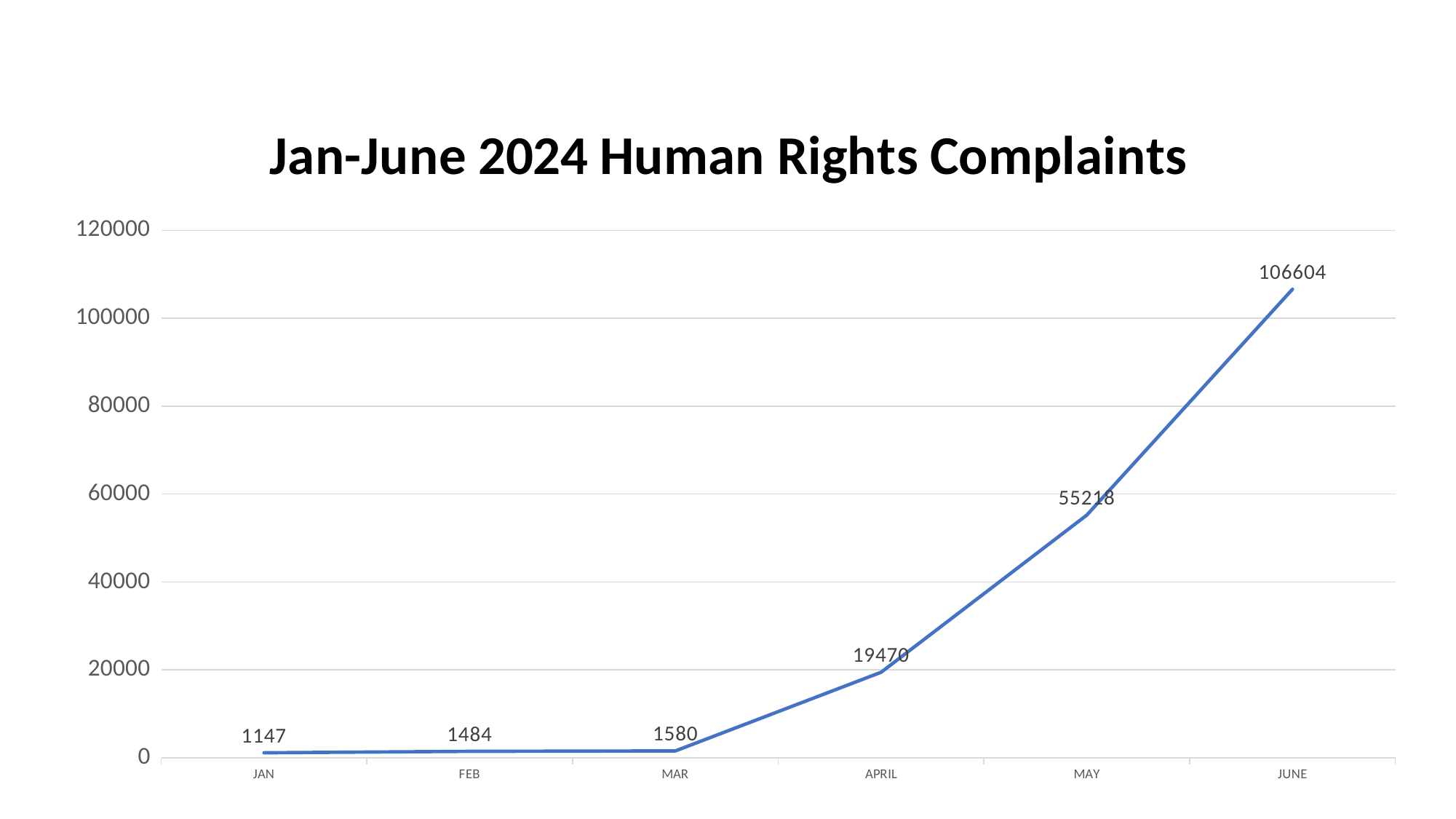
What is the value for MAY? 55218 What is the value for APRIL? 19470 What is the difference between the values for JUNE and MAY? 51386 Do the values rise or fall from JAN to JUNE? rise What is the value for JAN? 1147 Is the value for MAY greater or less than 40000? greater Which is larger, the value for MAR or the value for APRIL? APRIL Which month has the highest value? JUNE What kind of chart is shown? line chart How many months are plotted on the x axis? 6 Which month has the lowest value? JAN What is the difference between the values for FEB and JAN? 337